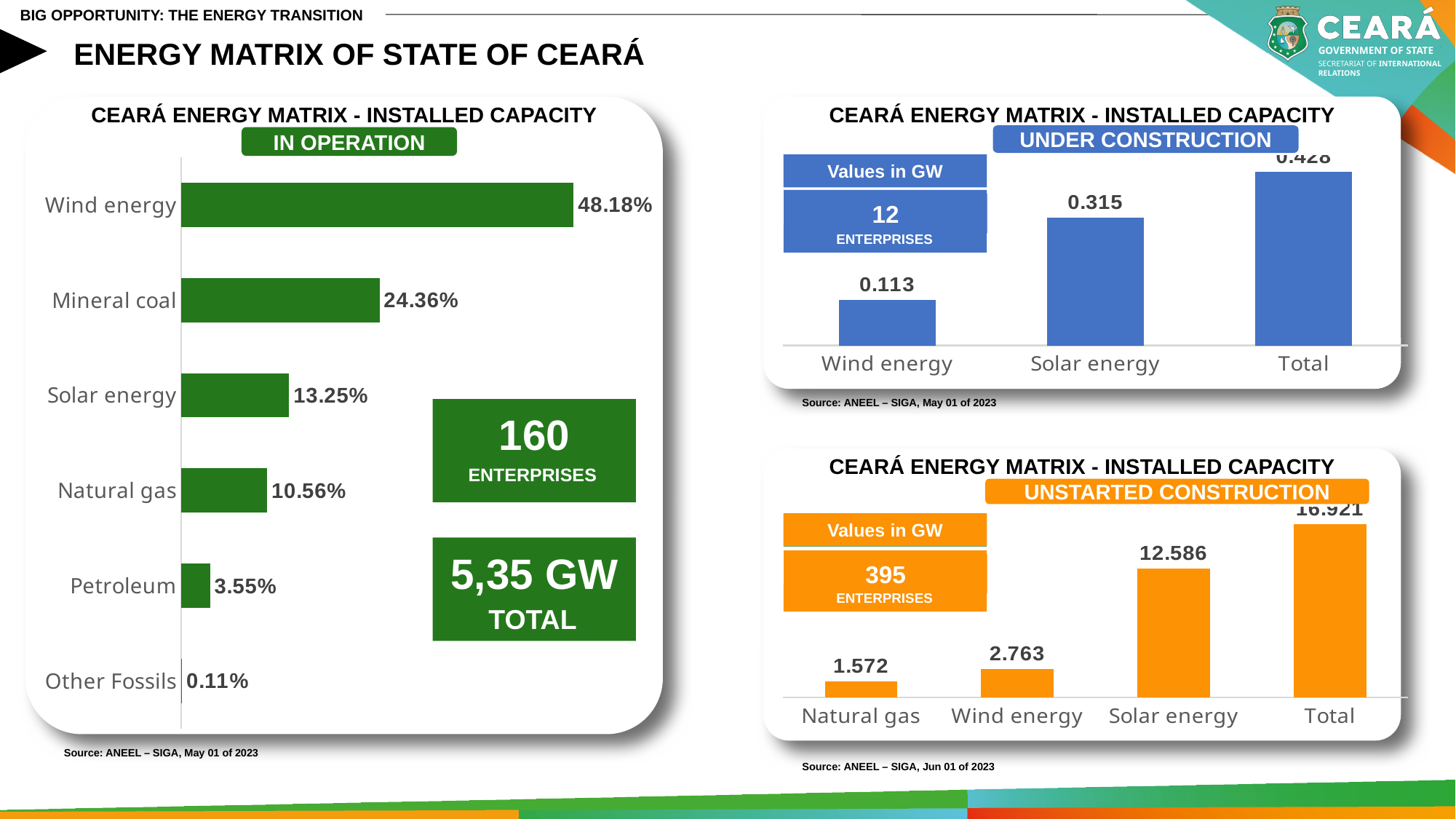
In the 'In Operation' chart, what is the value for Wind energy? 48.18% In the 'Under Construction' chart, which is larger, Wind energy or Solar energy? Solar energy In the 'Unstarted Construction' chart, how many bars are shown? 4 In the 'Under Construction' chart, what is the value for Solar energy? 0.315 What type of chart is the 'In Operation' chart? Bar chart In the 'Unstarted Construction' chart, what is the difference between Solar energy and Wind energy? 9.823 In the 'In Operation' chart, what is the value for Natural gas? 10.56% In the 'Unstarted Construction' chart, what is the value for Natural gas? 1.572 In the 'In Operation' chart, how many categories are shown? 6 In the 'In Operation' chart, which category has the lowest value? Other Fossils In the 'Under Construction' chart, what is the difference between Solar energy and Wind energy? 0.202 In the 'In Operation' chart, what is the difference between Wind energy and Mineral coal? 23.82%